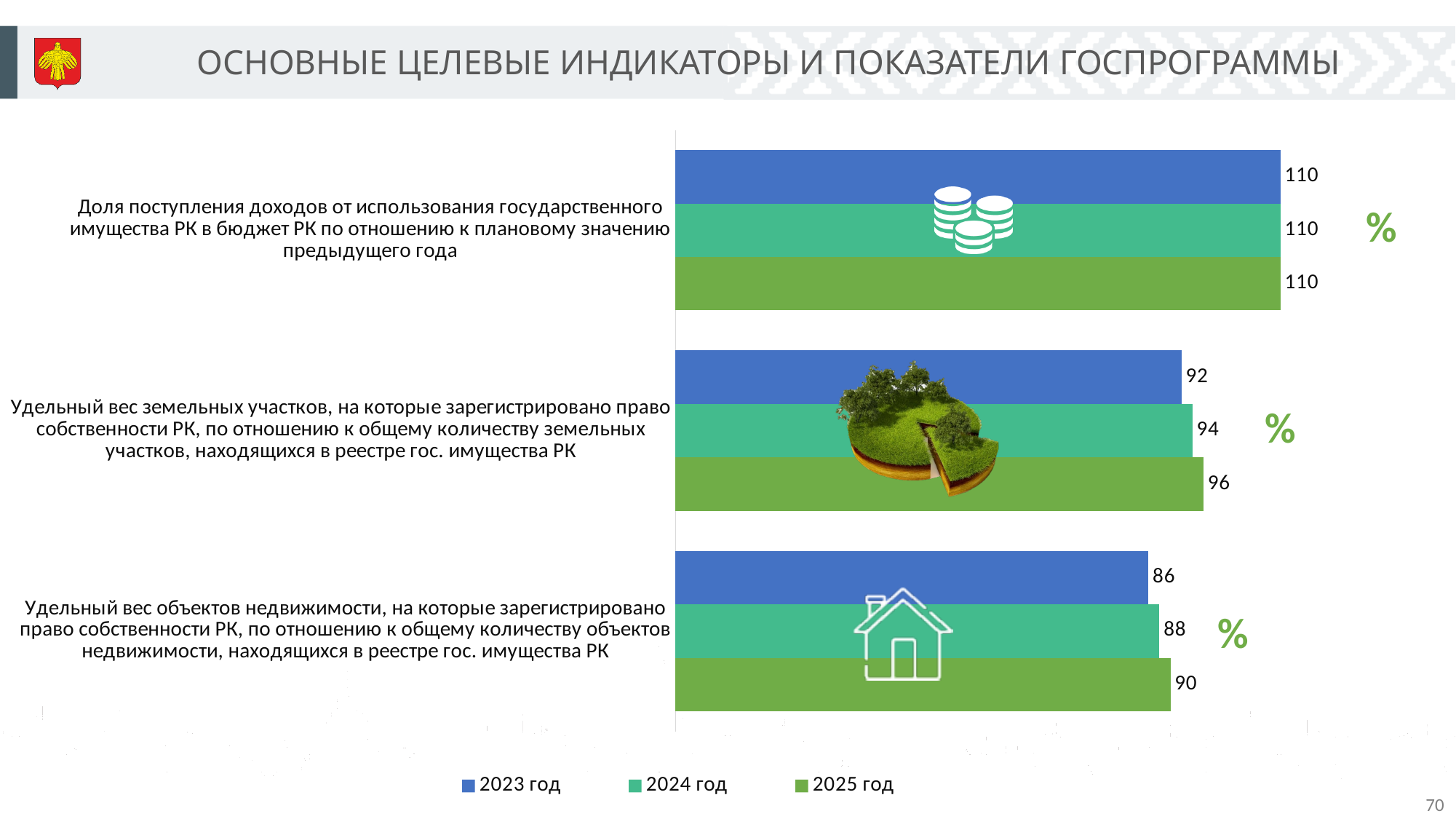
How many series does the legend list? 3 What is the 2024 год value for the indicator on the share of income from use of state property (Доля поступления доходов)? 110 What is the 2023 год value for the indicator on the share of land plots (земельных участков) with registered RK ownership? 92 What kind of chart is shown on the slide? bar chart How many indicators (categories) are shown in the chart? 3 What is the 2024 год value for the indicator on the share of land plots with registered RK ownership? 94 Do the values for the real estate objects indicator rise or fall from 2023 год to 2025 год? rise Which year has the highest value for the indicator on the share of real estate objects with registered RK ownership? 2025 год What is the difference between the 2025 год and 2023 год values for the indicator on the share of land plots with registered RK ownership? 4 What is the 2025 год value for the indicator on the share of real estate objects (объектов недвижимости) with registered RK ownership? 90 Which is larger: the 2024 год value for the land plots indicator or the 2024 год value for the real estate objects indicator? the land plots indicator (94) Which year has the lowest value for the indicator on the share of land plots with registered RK ownership? 2023 год